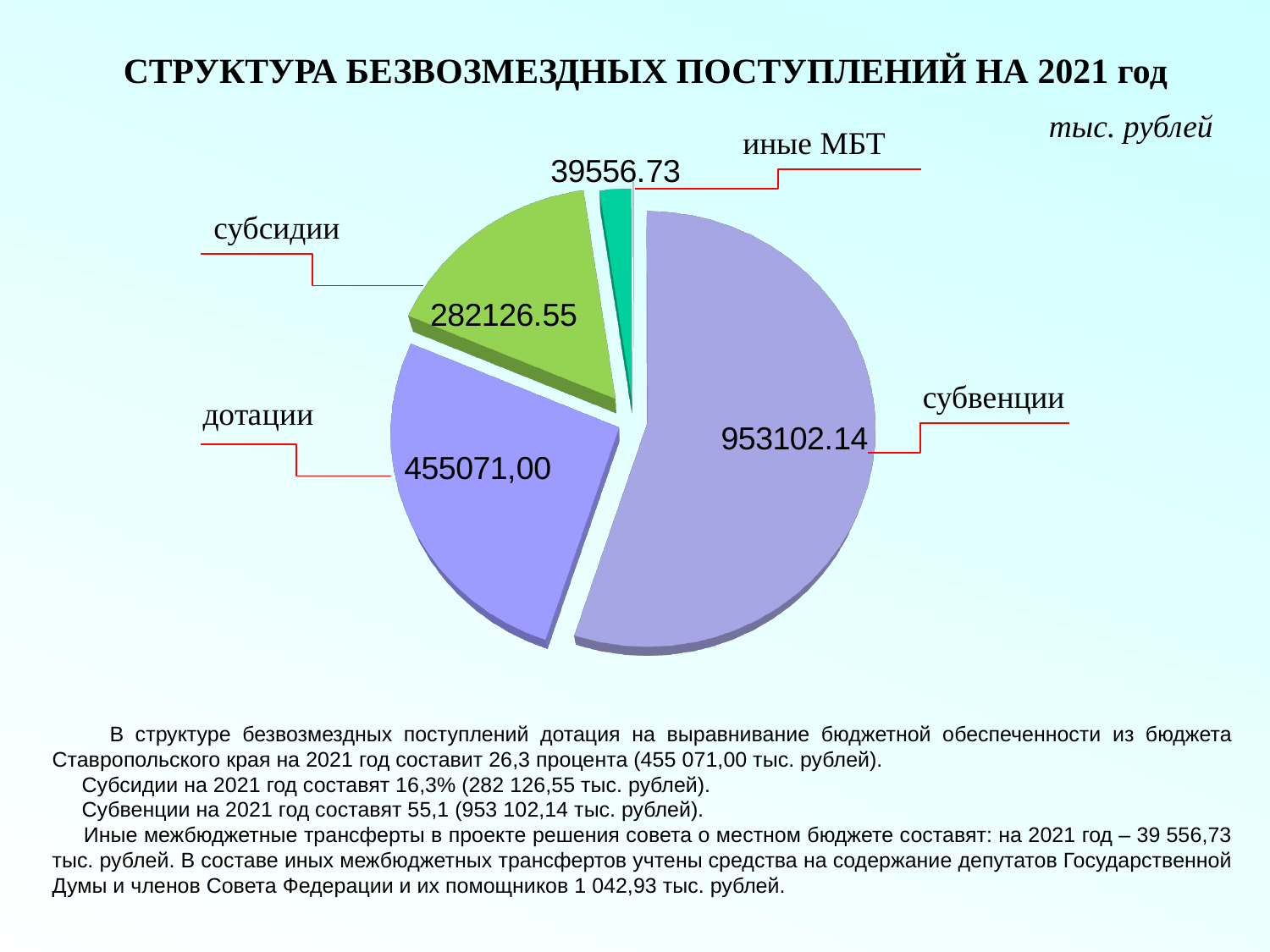
What is the value for субвенции in the pie chart? 953102.14 What is the value for субсидии in the pie chart? 282126.55 Which category has the largest slice of the pie chart? субвенции What is the difference between the values for субвенции and дотации? 498031.14 In what units are the values in the pie chart given? тыс. рублей What is the value for дотации in the pie chart? 455071,00 What type of chart is shown on the slide? pie chart Which is larger, the value for дотации or the value for субсидии? дотации What is the title of the chart on the slide? СТРУКТУРА БЕЗВОЗМЕЗДНЫХ ПОСТУПЛЕНИЙ НА 2021 год What is the value for иные МБТ in the pie chart? 39556.73